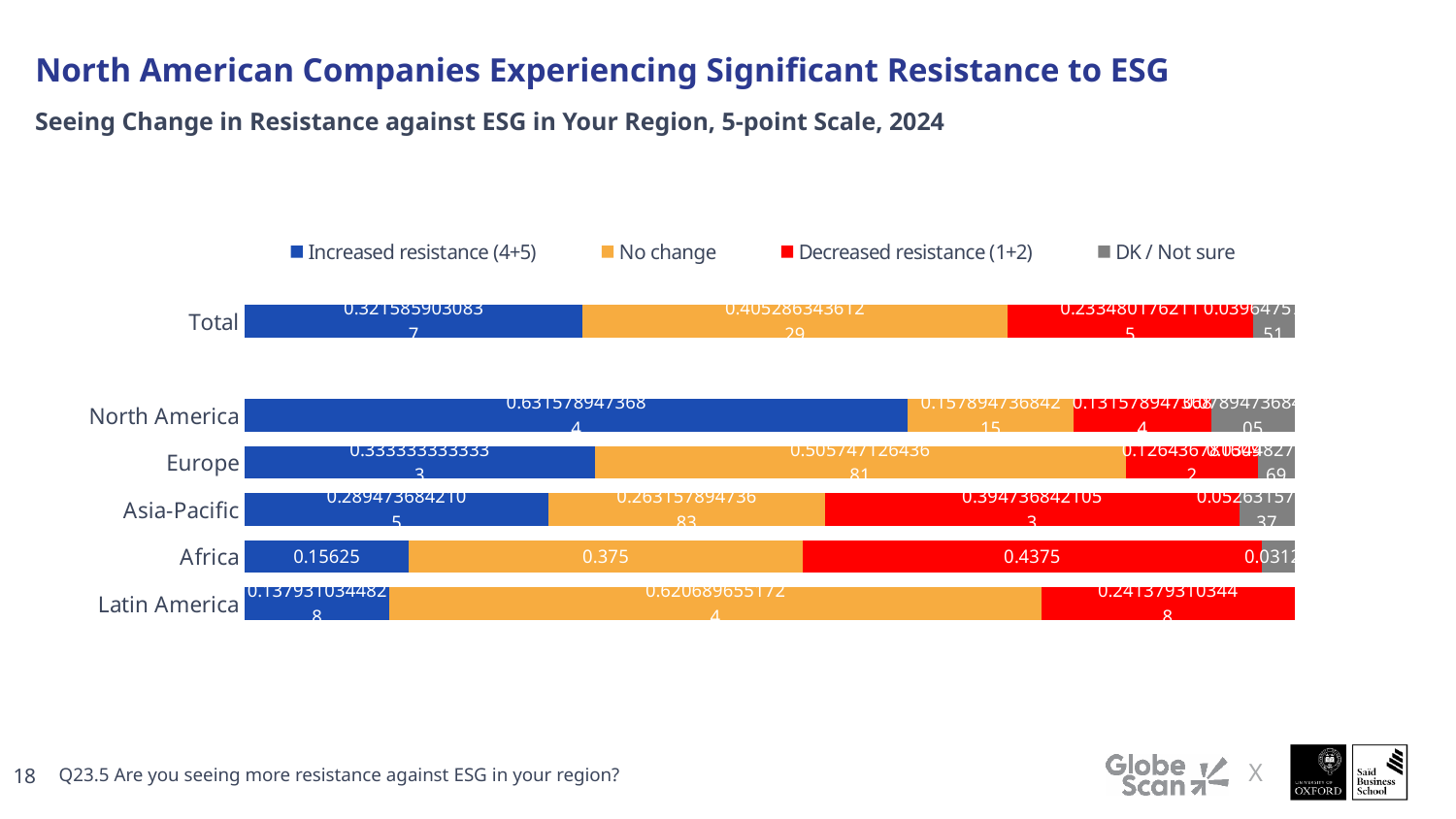
For Africa, which is larger: Decreased resistance (1+2) or No change? Decreased resistance (1+2) How many categories (bars) are plotted on the chart? 6 For Africa, what is the difference between Decreased resistance (1+2) and No change? 0.0625 Which region has the highest value for No change? Latin America What is the value for No change for Africa? 0.375 What is the value for Decreased resistance (1+2) for Africa? 0.4375 What kind of chart is shown on the slide? Stacked bar chart How many series does the legend list? 4 What is the value for Increased resistance (4+5) for Africa? 0.15625 Which region has the highest value for Increased resistance (4+5)? North America Which colour represents Decreased resistance (1+2) in the legend? Red Which region has the lowest value for No change? North America